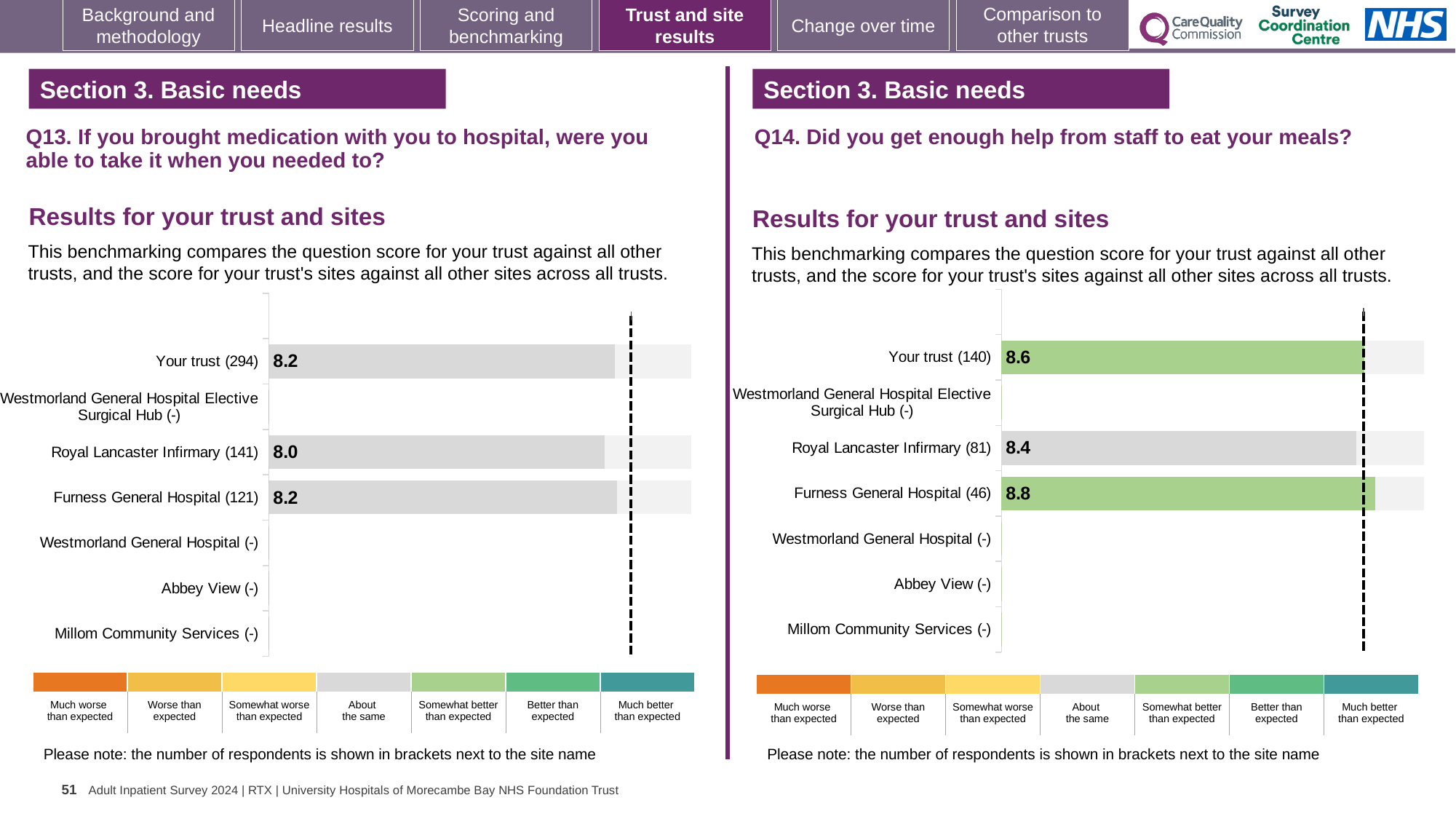
In the Q14 chart, what is the score for Royal Lancaster Infirmary? 8.4 In the Q13 chart, what is the difference between the scores for Furness General Hospital and Royal Lancaster Infirmary? 0.2 In the Q14 chart, what is the score for Furness General Hospital? 8.8 In the Q14 chart, what is the difference between the scores for Furness General Hospital and Your trust? 0.2 In the Q13 chart, what is the score for Your trust? 8.2 What kind of chart is used for the Q13 results? Bar chart In the Q14 chart, what is the score for Your trust? 8.6 In the Q14 chart, which site has the highest score? Furness General Hospital In the Q14 chart, which is larger: the score for Furness General Hospital or the score for Royal Lancaster Infirmary? Furness General Hospital In the Q13 chart, what is the score for Furness General Hospital? 8.2 In the Q13 chart, what is the score for Royal Lancaster Infirmary? 8.0 In the Q13 chart, which site with a plotted score has the lowest score? Royal Lancaster Infirmary